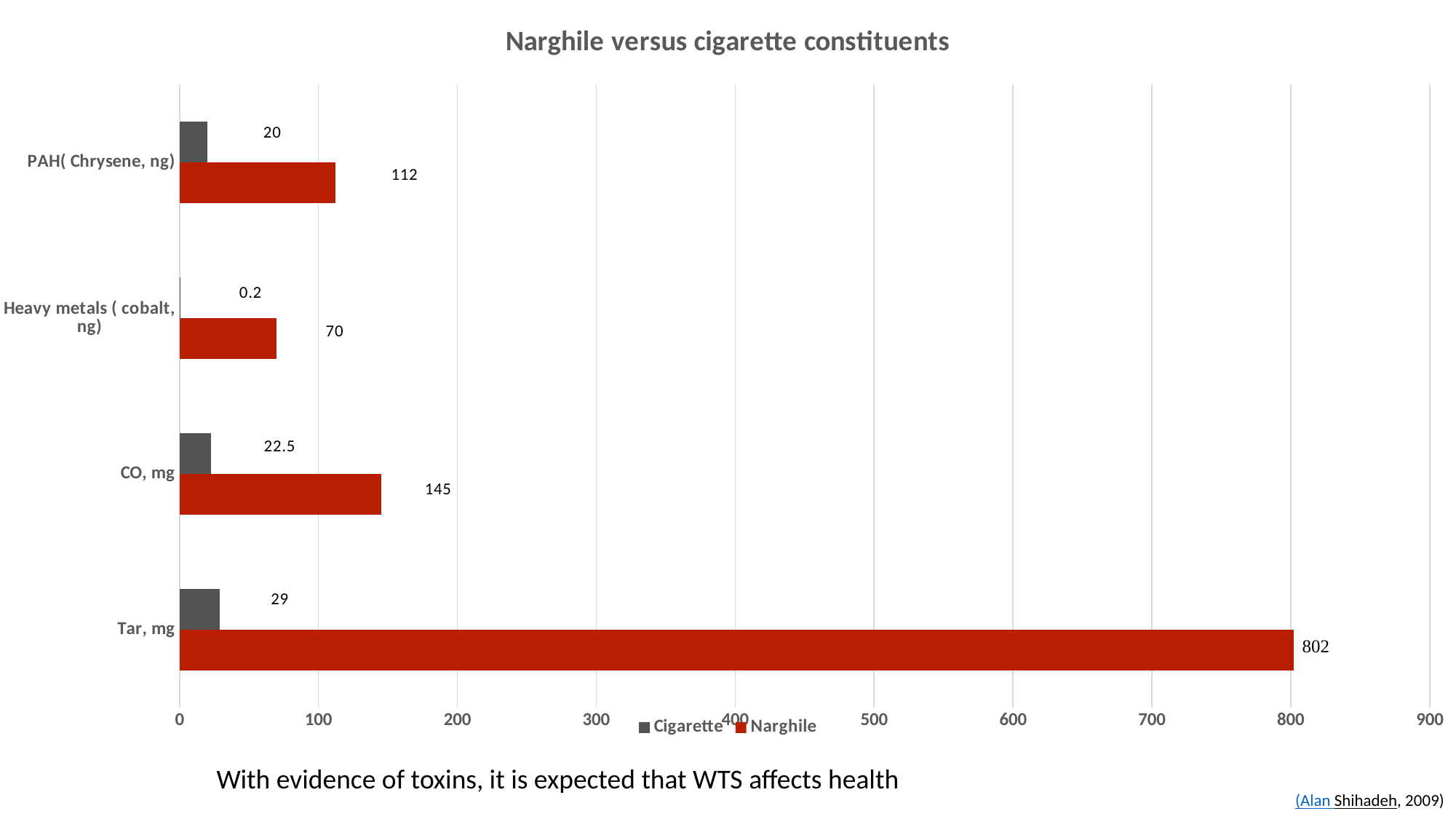
What is the difference between the Narghile and Cigarette values for CO, mg? 122.5 What is the Cigarette value for CO, mg? 22.5 Which category has the lowest Cigarette value? Heavy metals ( cobalt, ng) Which category has the highest Narghile value? Tar, mg Is the Narghile value for Heavy metals ( cobalt, ng) greater or less than 100? less What type of chart is shown? Bar chart What is the Cigarette value for Heavy metals ( cobalt, ng)? 0.2 Which is larger for Tar, mg: the Cigarette value or the Narghile value? Narghile How many categories are shown on the chart? 4 How many series does the legend list? 2 What is the Narghile value for PAH( Chrysene, ng)? 112 What is the Narghile value for Tar, mg? 802